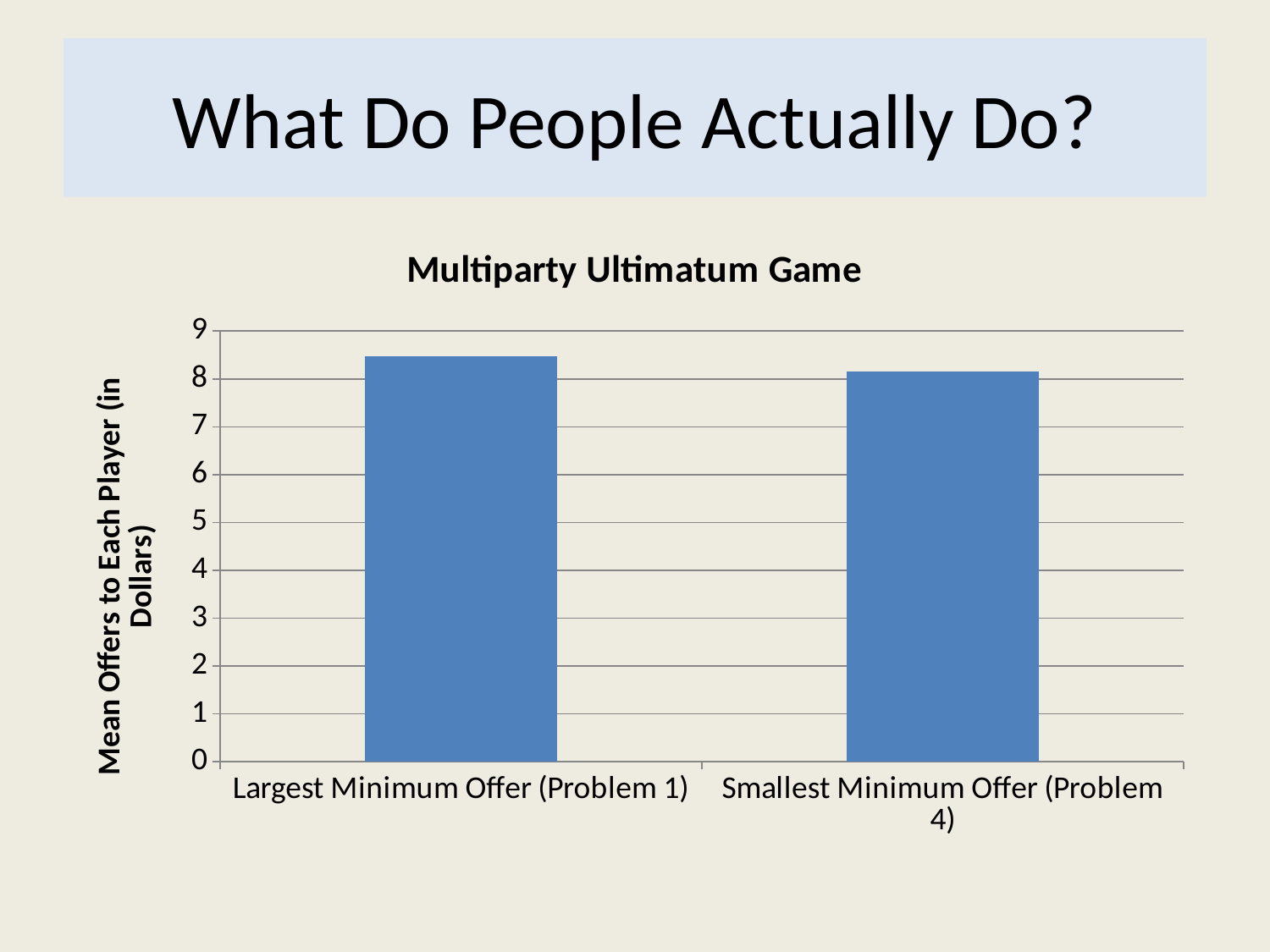
Is the value for Largest Minimum Offer (Problem 1) greater or less than 9? less What is the label of the vertical axis? Mean Offers to Each Player (in Dollars) Which category has the highest mean offer? Largest Minimum Offer (Problem 1) What kind of chart is shown on the slide? bar chart How many categories are plotted in the chart? 2 Is the value for Largest Minimum Offer (Problem 1) greater or less than 8? greater What is the title of the chart? Multiparty Ultimatum Game Which is larger, the mean offer for Largest Minimum Offer (Problem 1) or for Smallest Minimum Offer (Problem 4)? Largest Minimum Offer (Problem 1) Do the values rise or fall from left to right across the categories? fall Which category has the lowest mean offer? Smallest Minimum Offer (Problem 4) Is the value for Smallest Minimum Offer (Problem 4) greater or less than 7? greater